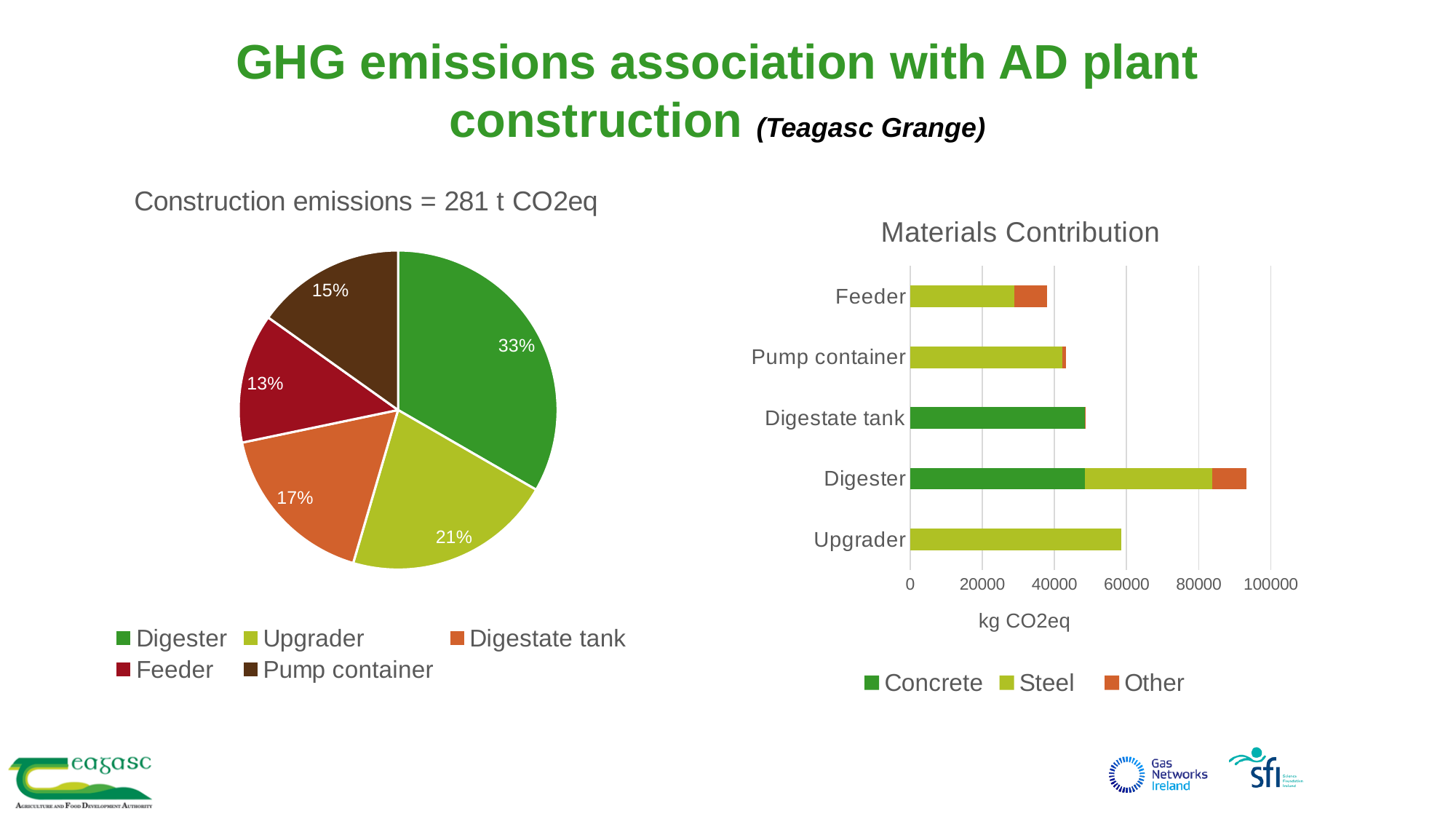
In the Materials Contribution chart, is the total value for Digester greater or less than 80000? greater In the pie chart on the left, which component has the smallest share of construction emissions? Feeder In the pie chart on the left, how many components are shown? 5 In the pie chart on the left, what share of construction emissions comes from the Pump container? 15% In the pie chart on the left, what is the difference in percentage points between the Upgrader and Digestate tank shares? 4 What total construction emissions figure is stated above the pie chart? 281 t CO2eq In the pie chart on the left, what share of construction emissions comes from the Digester? 33% What kind of chart is the Materials Contribution chart? bar chart In the pie chart on the left, which component has the largest share of construction emissions? Digester In the Materials Contribution chart, which component has the longest bar? Digester In the pie chart on the left, what share of construction emissions comes from the Feeder? 13% In the Materials Contribution chart, how many series does the legend list? 3